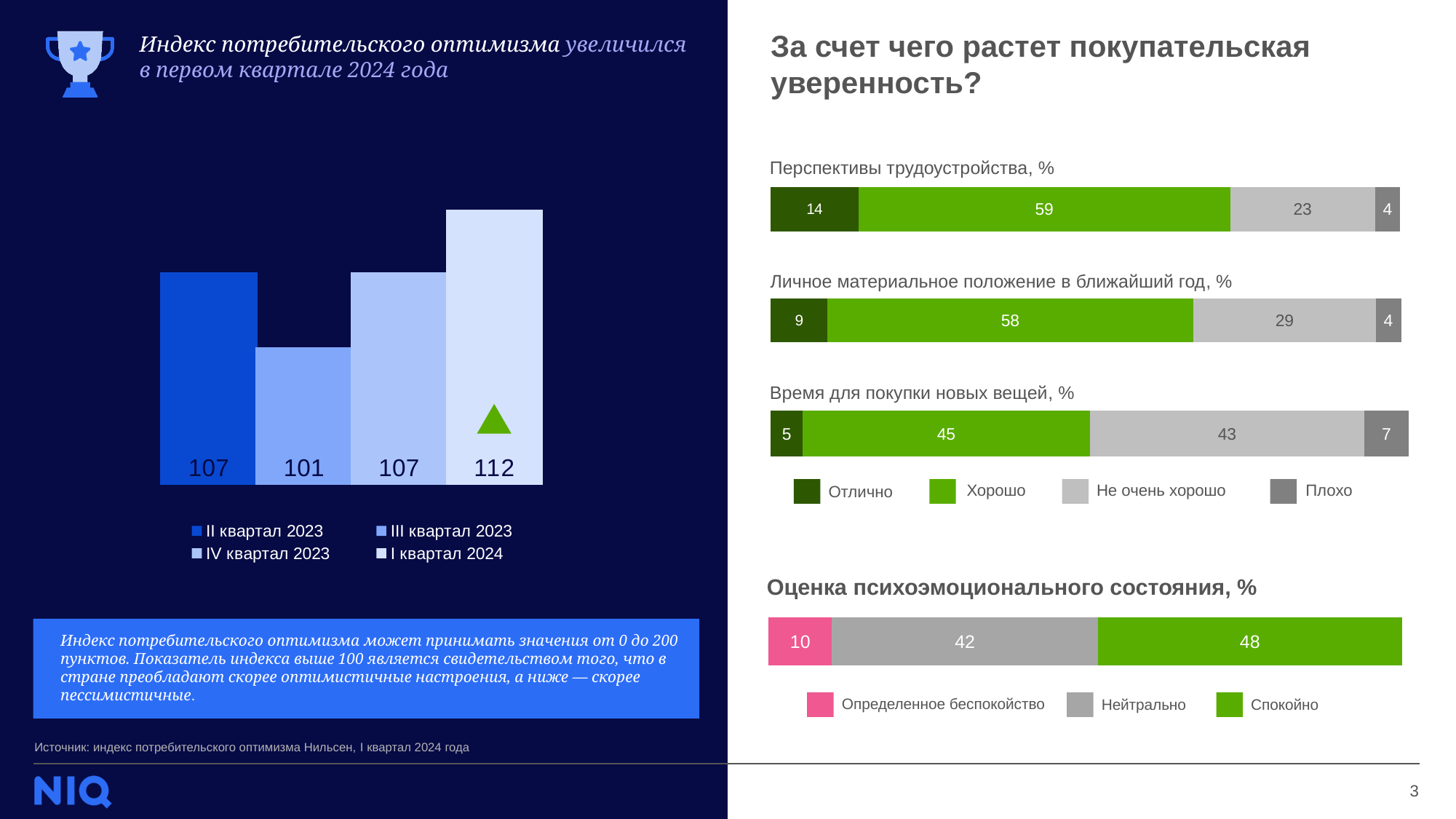
In the 'Время для покупки новых вещей, %' chart, which is larger: Хорошо or Не очень хорошо? Хорошо In the 'Личное материальное положение в ближайший год, %' chart, what is the value for Не очень хорошо? 29 In the consumer optimism index bar chart on the left, which quarter has the lowest value? III квартал 2023 In the consumer optimism index bar chart on the left, how many entries does the legend list? 4 In the consumer optimism index bar chart on the left, which quarter has the highest value? I квартал 2024 What kind of chart is the consumer optimism index chart on the left? bar chart In the 'Время для покупки новых вещей, %' chart, what is the difference between Плохо and Отлично? 2 In the consumer optimism index bar chart on the left, what is the value for I квартал 2024? 112 In the 'Оценка психоэмоционального состояния, %' chart, what is the value for Спокойно? 48 In the consumer optimism index bar chart on the left, what is the value for III квартал 2023? 101 In the 'Перспективы трудоустройства, %' chart, what is the value for Хорошо? 59 In the consumer optimism index bar chart on the left, what is the difference between I квартал 2024 and IV квартал 2023? 5